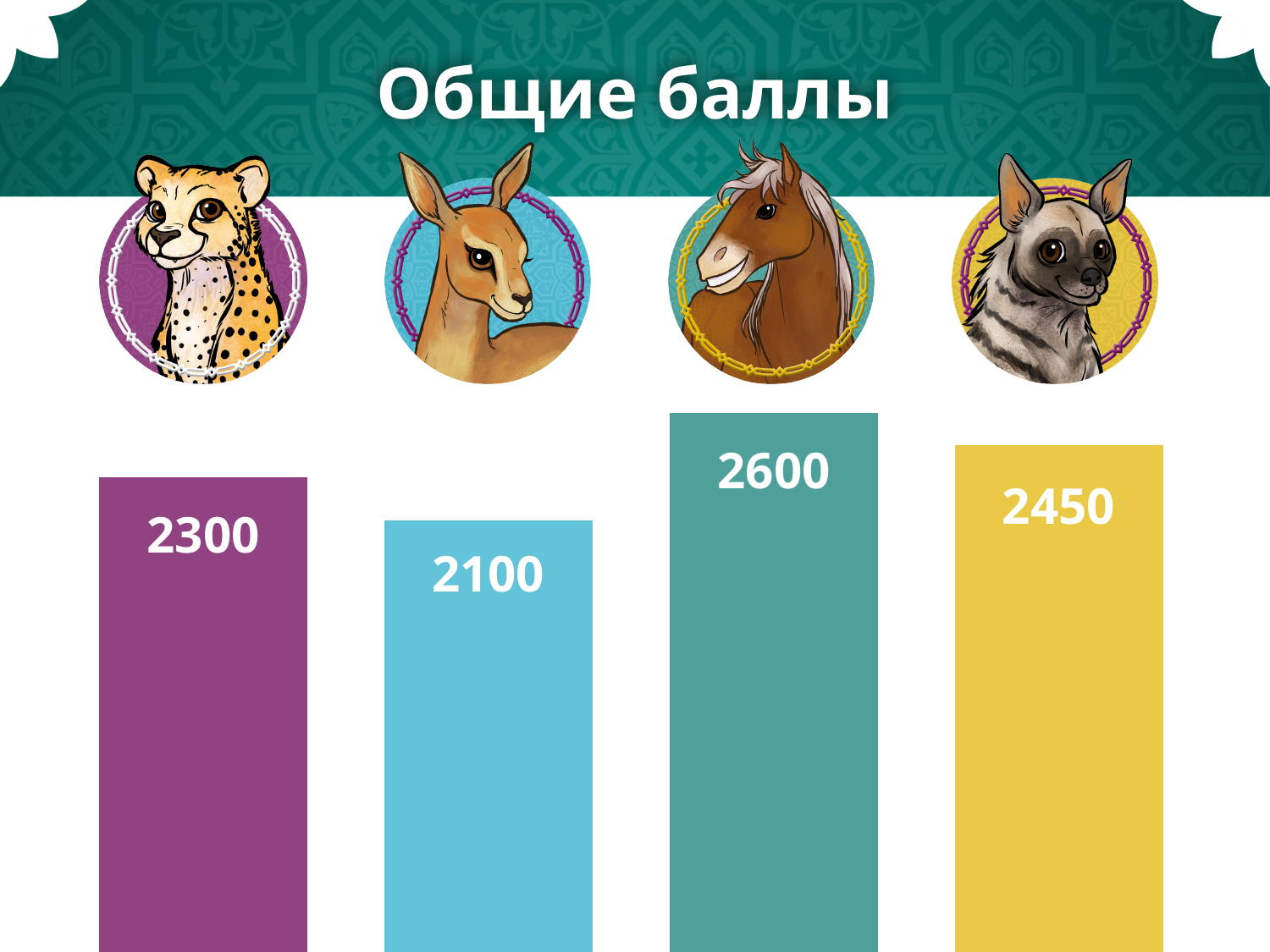
What is the difference between the highest and lowest bar values? 500 What is the value of the third (teal) bar, under the horse? 2600 How many bars are shown in the chart? 4 What is the title of the chart? Общие баллы What is the value of the fourth (rightmost, yellow) bar, under the hyena? 2450 Which bar has the lowest value? The second bar (gazelle), 2100 Which is larger: the value of the first bar (cheetah) or the fourth bar (hyena)? The fourth bar (hyena), 2450 What is the value of the first (leftmost, purple) bar? 2300 What is the value of the second (light blue) bar, under the gazelle? 2100 What is the difference between the first bar (2300) and the fourth bar (2450)? 150 Which bar has the highest value? The third bar (horse), 2600 What kind of chart is shown on the slide? Bar chart